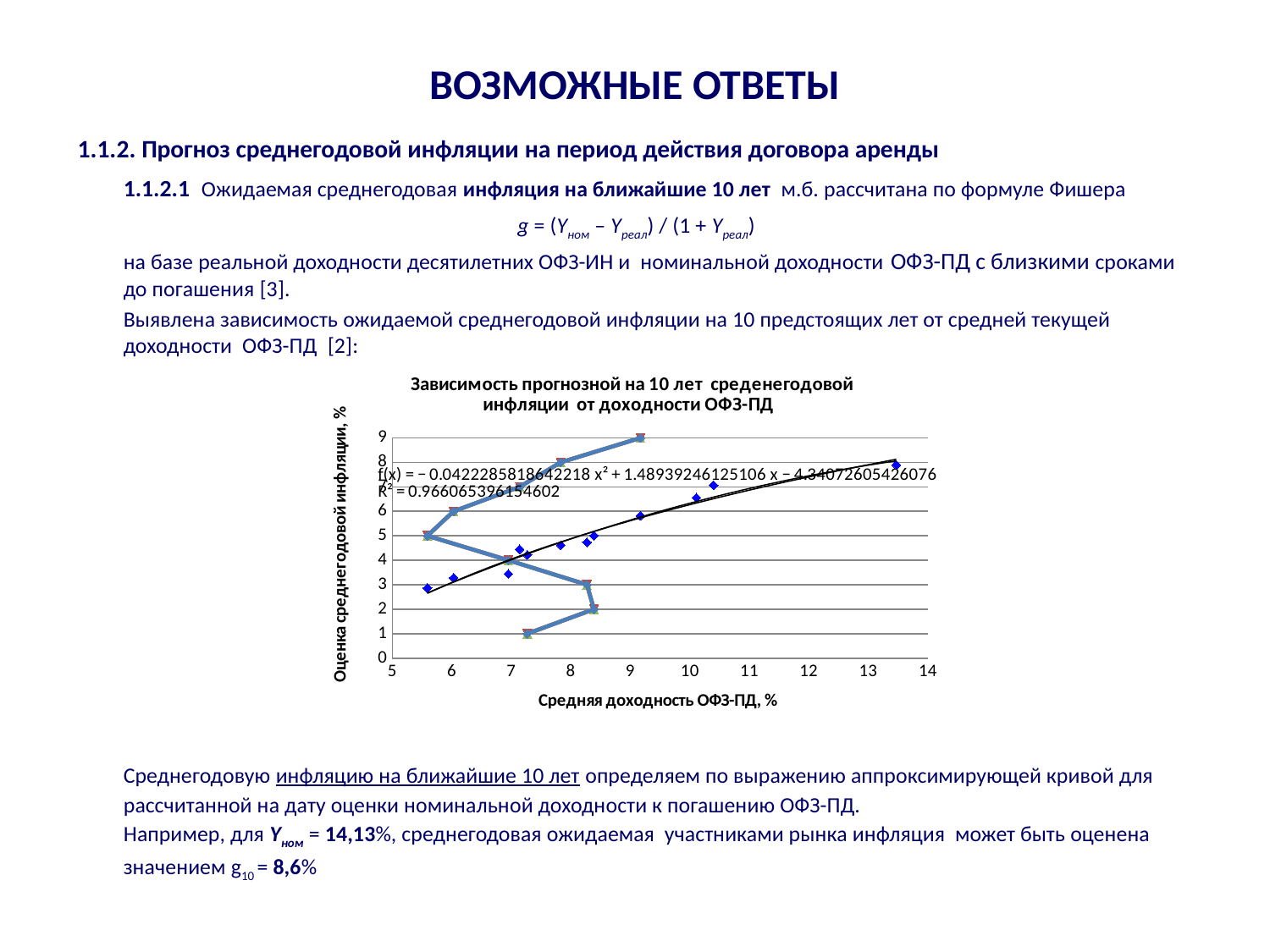
What R² value is printed on the chart for the fitted curve? 0.966065396154602 What is the highest tick value shown on the y axis of the chart? 9 What kind of chart is shown on the slide? scatter chart What is the title of the y axis of the chart? Оценка среднегодовой инфляции, % What is the title of the x axis of the chart? Средняя доходность ОФЗ-ПД, % Does the fitted curve on the chart rise or fall as the ОФЗ-ПД yield on the x axis increases? rises